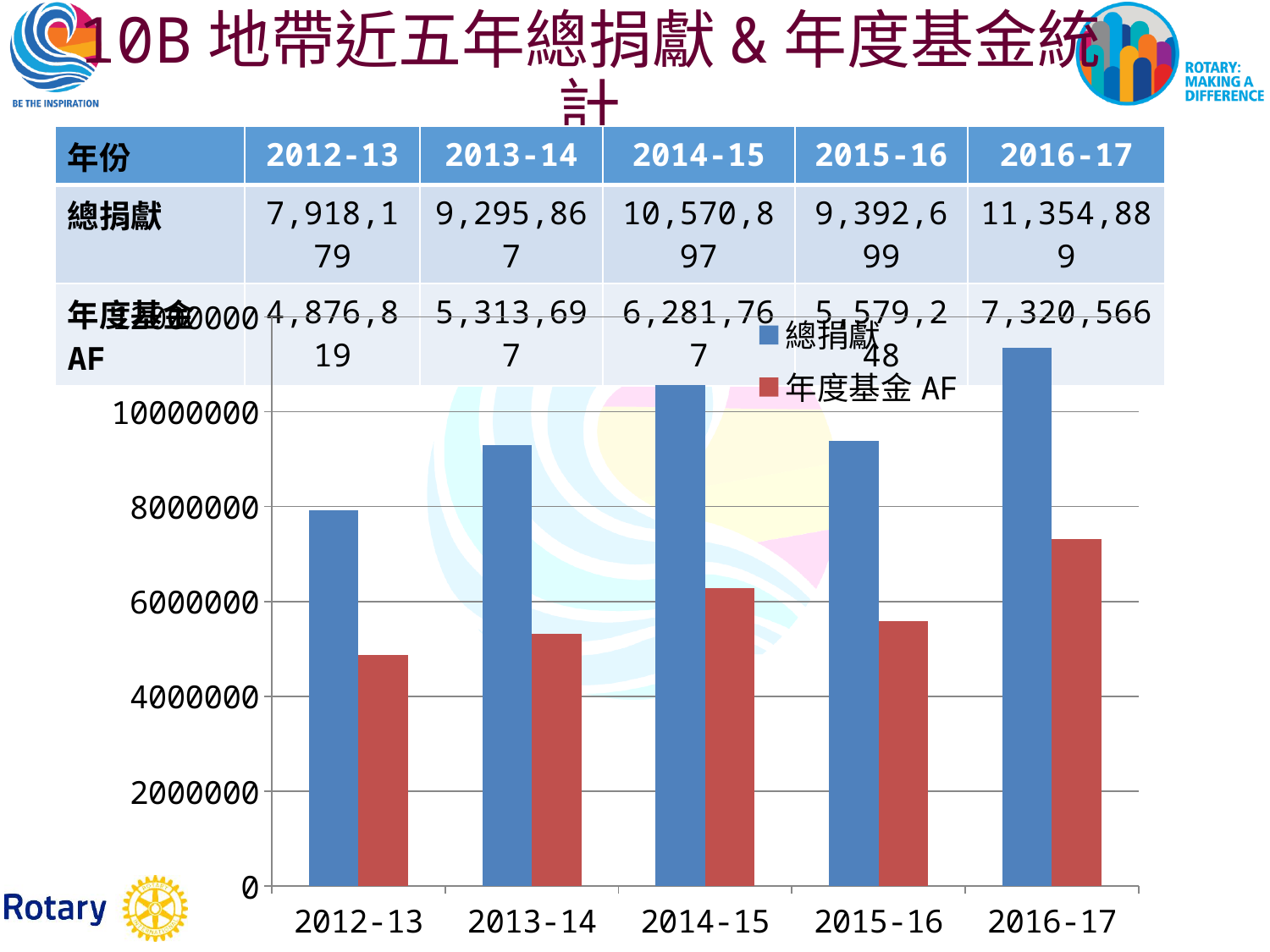
Which year has the lowest 年度基金 AF? 2012-13 Is the 年度基金 AF value for 2014-15 greater or less than 6000000? greater How many series does the chart legend list? 2 What is the 年度基金 AF value for 2016-17? 7,320,566 Does 總捐獻 rise or fall from 2014-15 to 2015-16? fall What is the 總捐獻 value for 2014-15? 10,570,897 Which colour represents 年度基金 AF in the chart? red Which is larger, 總捐獻 in 2013-14 or 總捐獻 in 2015-16? 2015-16 Which year has the highest 總捐獻? 2016-17 What type of chart is shown on the slide? bar chart What is the difference between 總捐獻 and 年度基金 AF in 2016-17? 4,034,323 How many year categories are shown on the x axis of the chart? 5